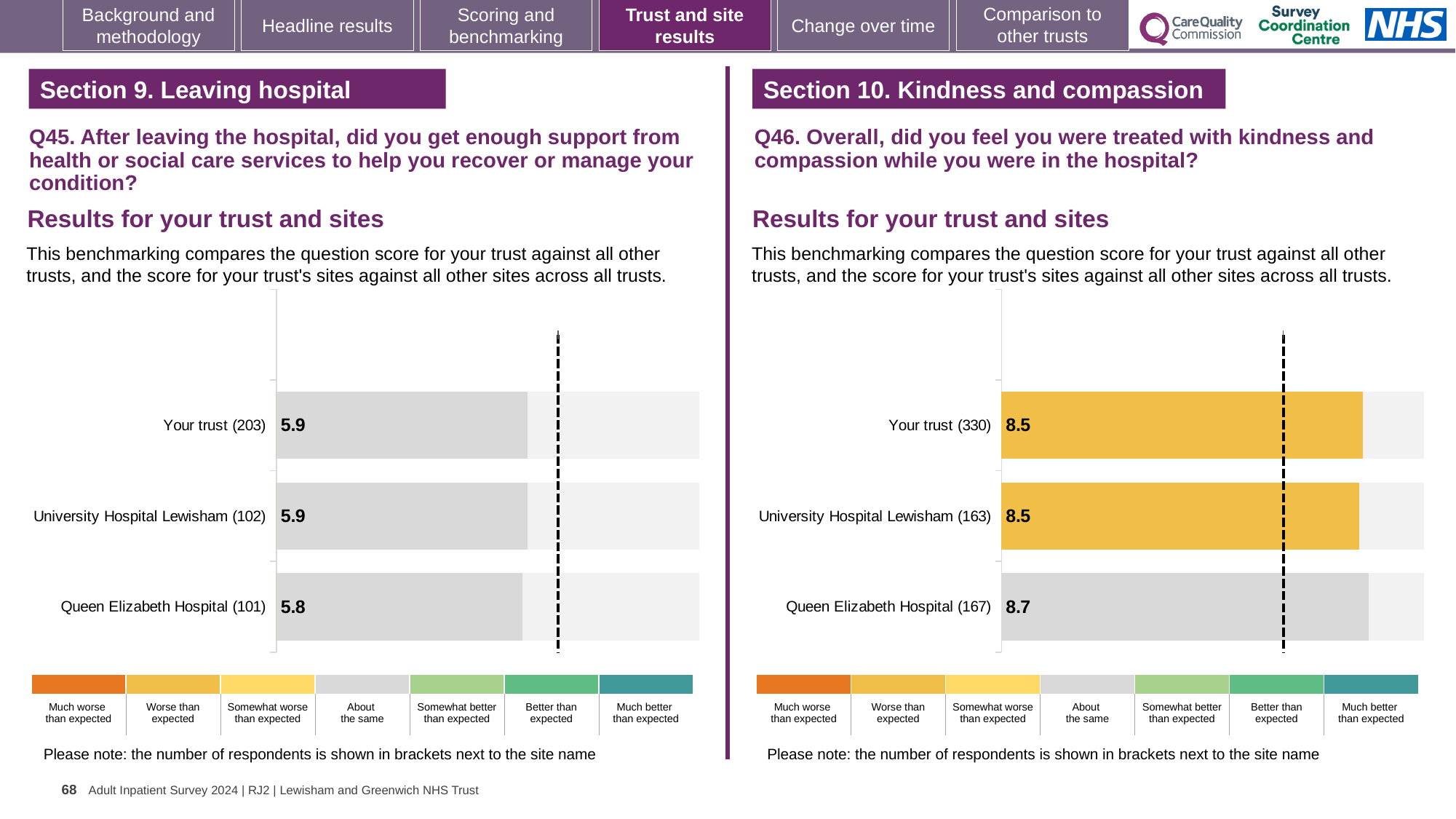
On the Q46 chart (right), which has the larger score: University Hospital Lewisham or Queen Elizabeth Hospital? Queen Elizabeth Hospital What kind of chart is used on the Q46 chart (right)? Bar chart On the Q45 chart (left), what is the difference between the score for Your trust and the score for Queen Elizabeth Hospital? 0.1 On the Q45 chart (left), what is the score for Queen Elizabeth Hospital? 5.8 How many bars are plotted on the Q45 chart (left)? 3 On the Q46 chart (right), what is the score for Queen Elizabeth Hospital? 8.7 On the Q46 chart (right), how many respondents are shown in brackets for Your trust? 330 On the Q46 chart (right), what is the score for University Hospital Lewisham? 8.5 On the Q46 chart (right), which site or trust has the highest score? Queen Elizabeth Hospital On the Q45 chart (left), what is the score for Your trust? 5.9 On the Q46 chart (right), what is the difference between the score for Queen Elizabeth Hospital and the score for Your trust? 0.2 On the Q45 chart (left), which site or trust has the lowest score? Queen Elizabeth Hospital